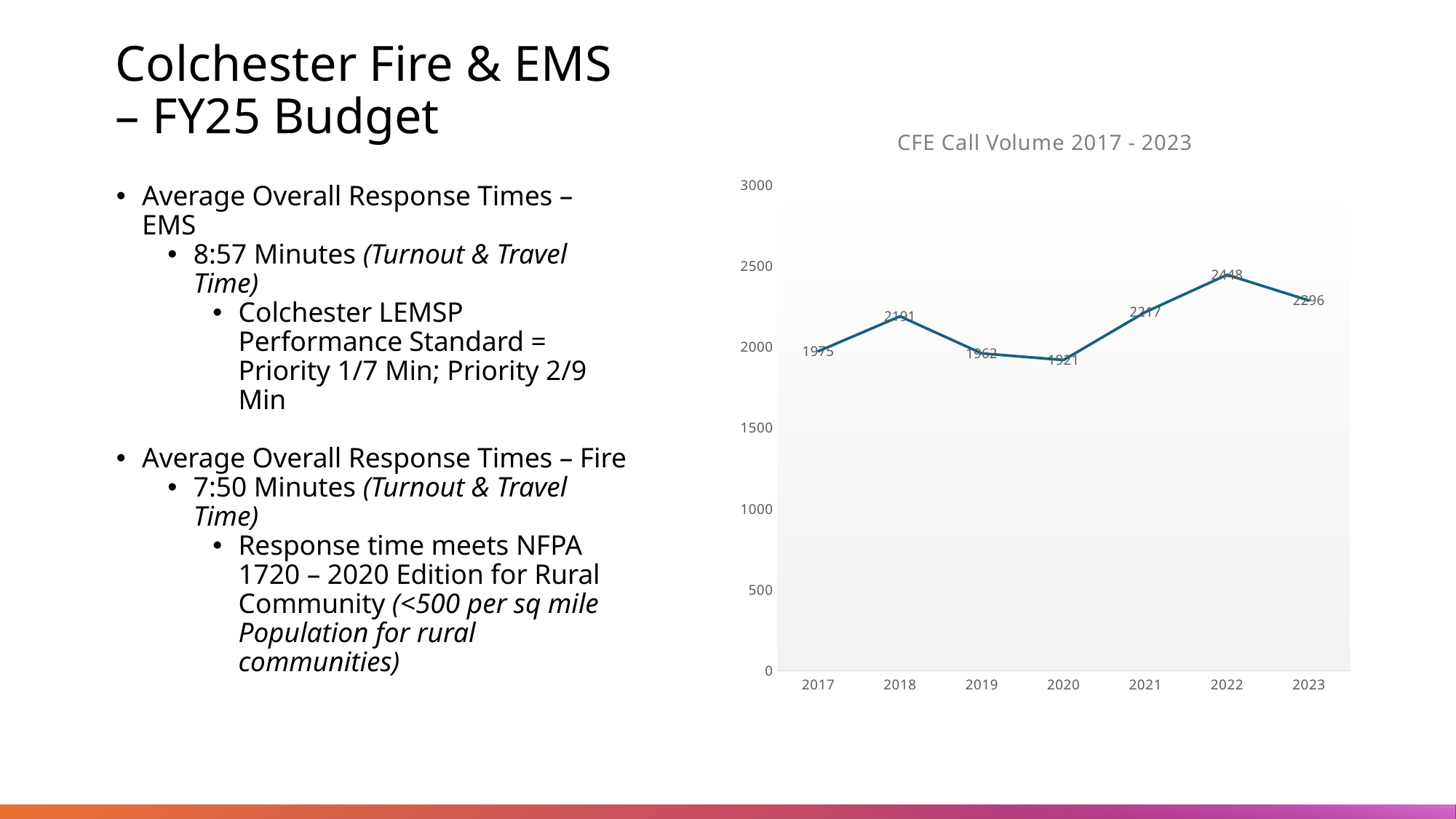
Which year had a higher call volume, 2018 or 2021? 2021 What was the CFE call volume in 2017? 1975 What is the title of the chart? CFE Call Volume 2017 - 2023 How many years are plotted on the chart? 7 Is the call volume for 2019 greater or less than 2000? less What kind of chart is shown on the slide? line chart What was the CFE call volume in 2022? 2448 Did the call volume rise or fall from 2020 to 2022? rise What was the CFE call volume in 2020? 1921 Which year had the highest CFE call volume? 2022 What is the difference in call volume between 2022 and 2023? 152 Which year had the lowest CFE call volume? 2020